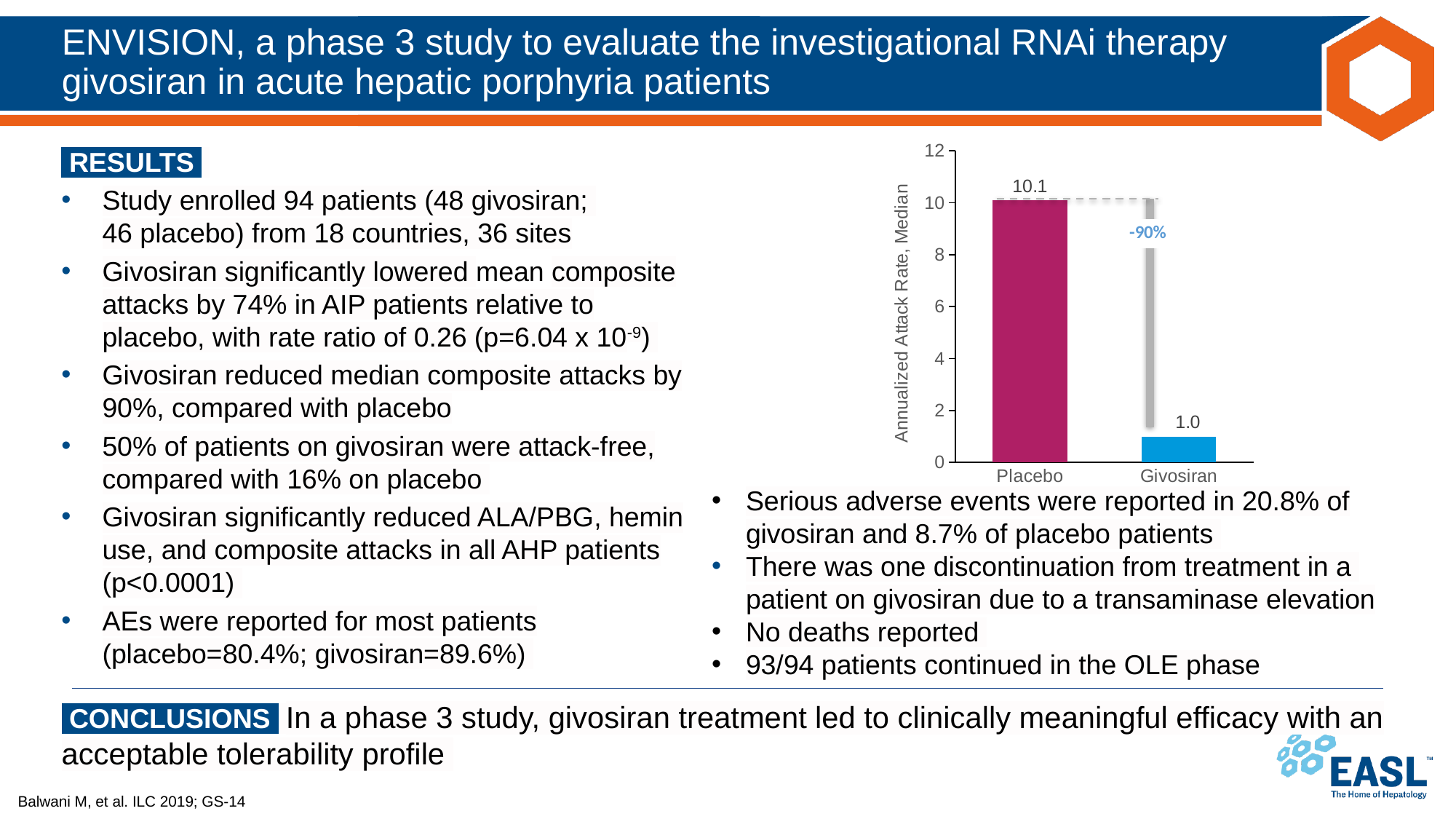
What is the annualized attack rate (median) for Givosiran in the chart? 1.0 Which group has the higher median annualized attack rate in the chart? Placebo What percentage reduction is annotated between the two bars in the chart? -90% How many groups are shown on the x axis of the chart? 2 Is the median annualized attack rate for Placebo greater or less than 8? greater What is the difference between the Placebo and Givosiran median annualized attack rates in the chart? 9.1 What kind of chart is shown on the slide? Bar chart What is the annualized attack rate (median) for Placebo in the chart? 10.1 What is the maximum value shown on the y axis of the chart? 12 Is the median annualized attack rate for Givosiran greater or less than 2? less Which group has the lower median annualized attack rate in the chart? Givosiran What is the label of the y axis in the chart? Annualized Attack Rate, Median